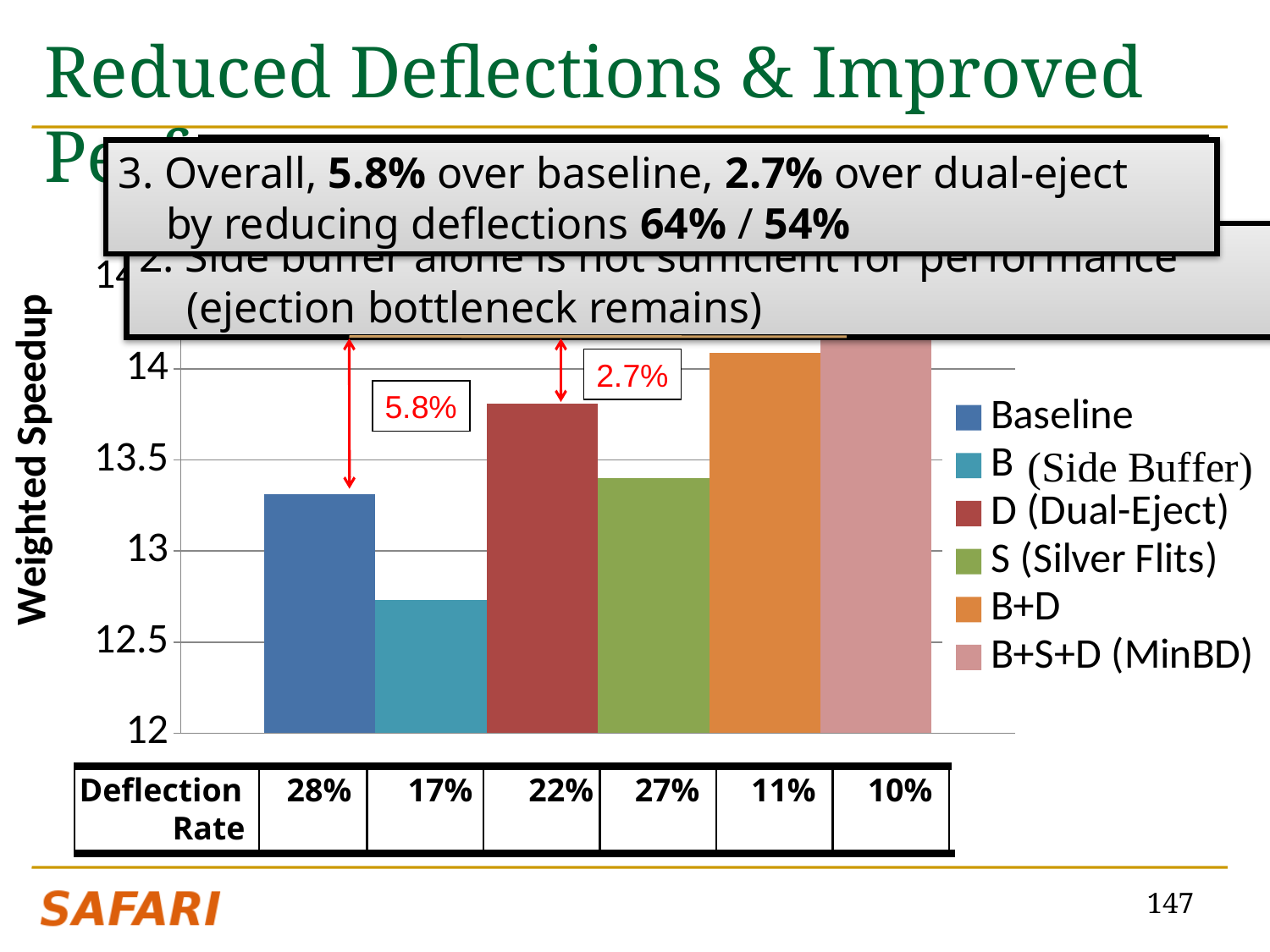
Is the weighted speedup for B+D greater or less than 14? greater Which has a higher weighted speedup, D (Dual-Eject) or S (Silver Flits)? D (Dual-Eject) Which configuration has the highest weighted speedup? B+S+D (MinBD) What kind of chart is shown on the slide? bar chart What deflection rate is shown for the Baseline configuration in the table below the chart? 28% Which configuration has the lowest weighted speedup? B (Side Buffer) What is the title of the vertical axis? Weighted Speedup How many entries does the chart legend list? 6 What deflection rate is shown for B+S+D (MinBD) in the table below the chart? 10% How many bars are plotted in the chart? 6 Is the weighted speedup for Baseline greater or less than 13.5? less Is the weighted speedup for B (Side Buffer) greater or less than 13? less